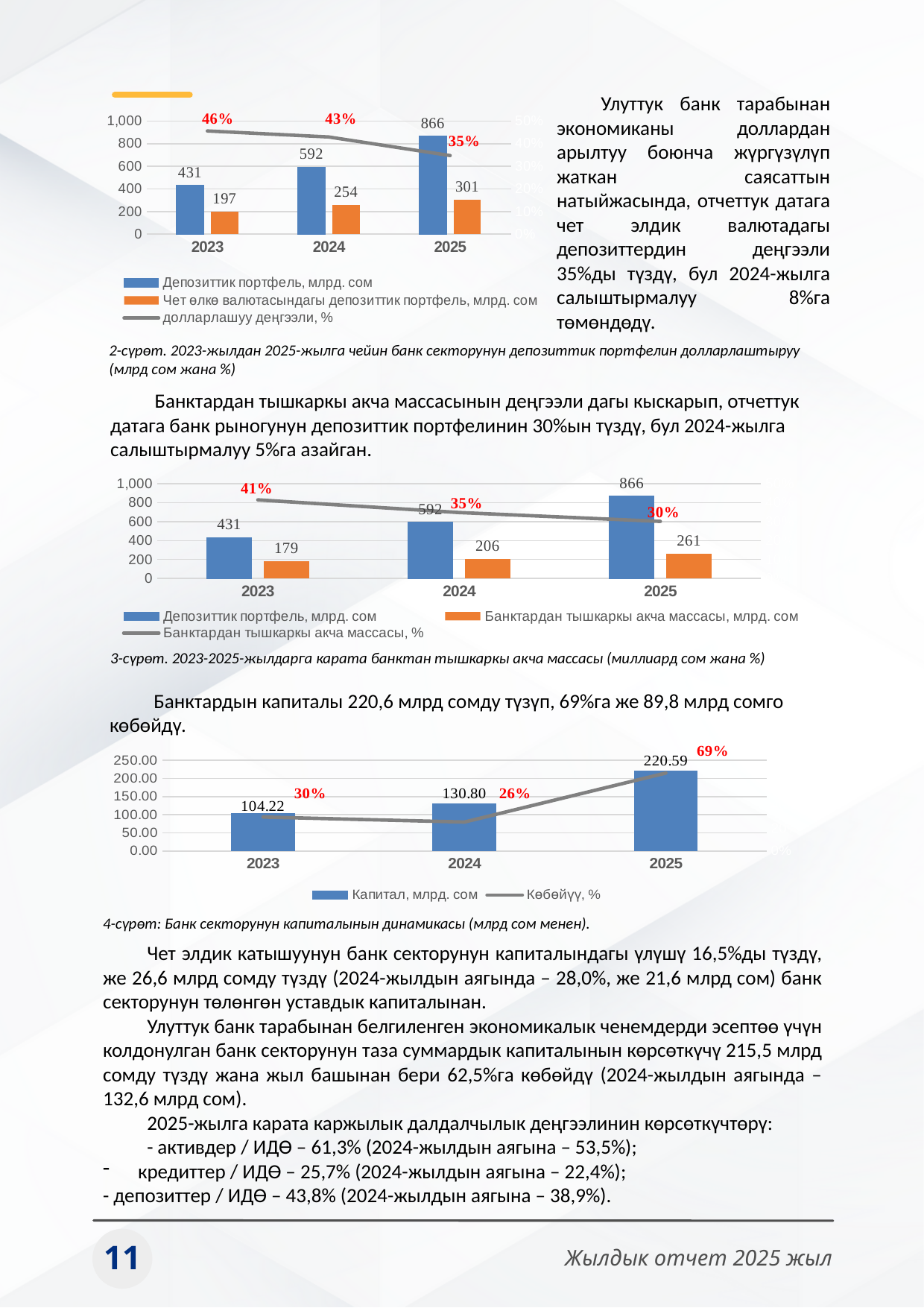
How many series does the legend of the top chart (2-сүрөт) list? 3 What type of chart is the bottom chart (4-сүрөт)? Combined bar and line chart In the bottom chart (4-сүрөт), what is the Көбөйүү, % for 2025? 69% In the middle chart (3-сүрөт), what is the value of Банктардан тышкаркы акча массасы, млрд. сом for 2023? 179 In the bottom chart (4-сүрөт), what is the value of Капитал, млрд. сом for 2024? 130.80 In the middle chart (3-сүрөт), which year has the highest Банктардан тышкаркы акча массасы, млрд. сом? 2025 In the top chart (2-сүрөт), what is the difference between the Депозиттик портфель and the Чет өлкө валютасындагы депозиттик портфель in 2024? 338 In the top chart (2-сүрөт), what is the value of Депозиттик портфель, млрд. сом for 2025? 866 In the top chart (2-сүрөт), does the долларлашуу деңгээли line rise or fall from 2023 to 2025? fall In the top chart (2-сүрөт), what is the долларлашуу деңгээли, % for 2023? 46% In the middle chart (3-сүрөт), what is the Банктардан тышкаркы акча массасы, % for 2025? 30% In the bottom chart (4-сүрөт), what is the difference in Капитал, млрд. сом between 2025 and 2024? 89.79